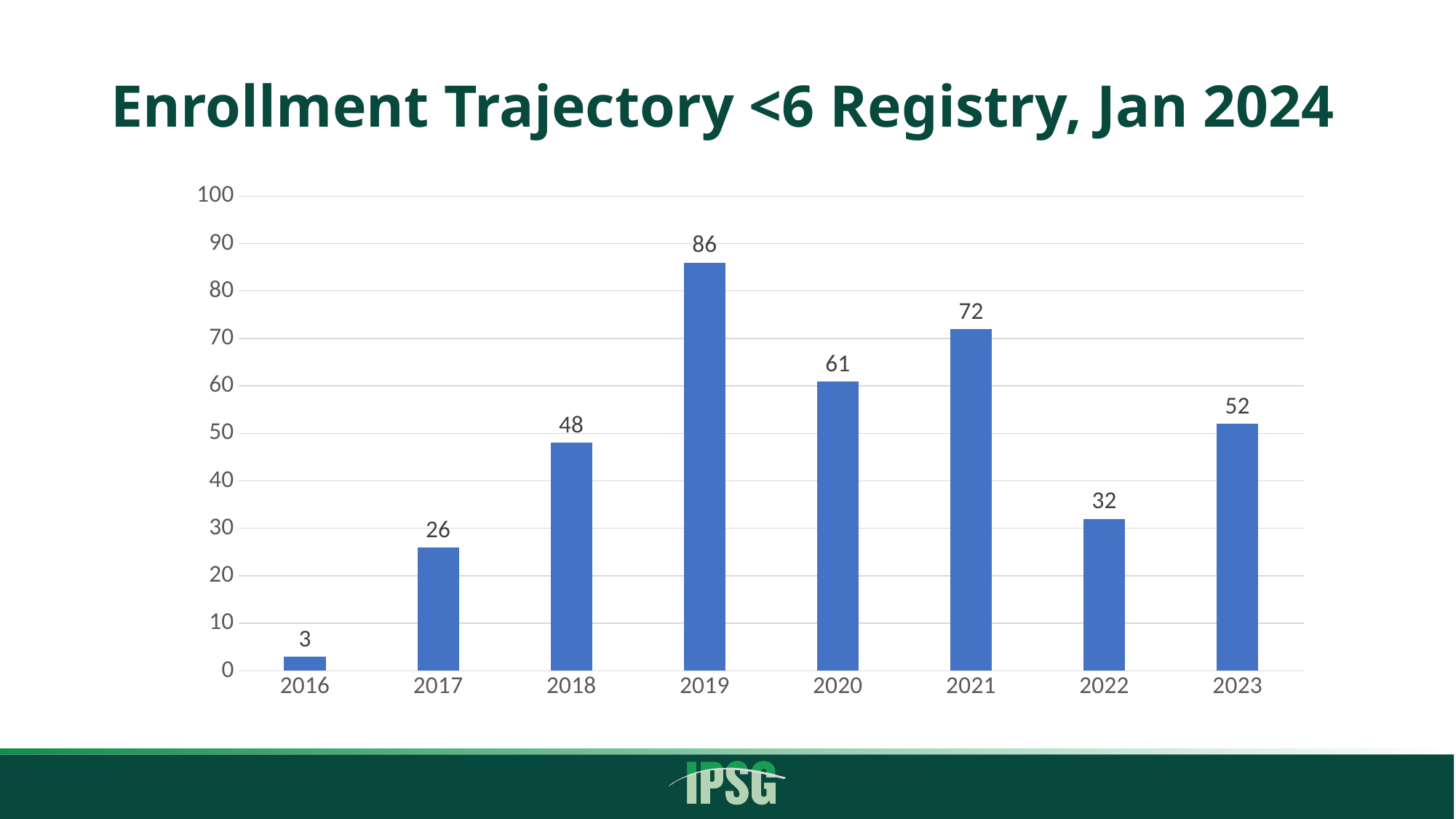
How many years are shown on the x axis? 8 What is the difference between the enrollment values for 2019 and 2023? 34 Which year has the highest enrollment? 2019 What is the difference between the enrollment values for 2021 and 2020? 11 Do the enrollment values rise or fall from 2016 to 2019? Rise What is the enrollment value for 2016? 3 Which year has the larger enrollment, 2018 or 2023? 2023 What kind of chart is shown on the slide? Bar chart What is the enrollment value for 2019? 86 Is the value for 2017 greater or less than 30? less What is the enrollment value for 2022? 32 Which year has the lowest enrollment? 2016